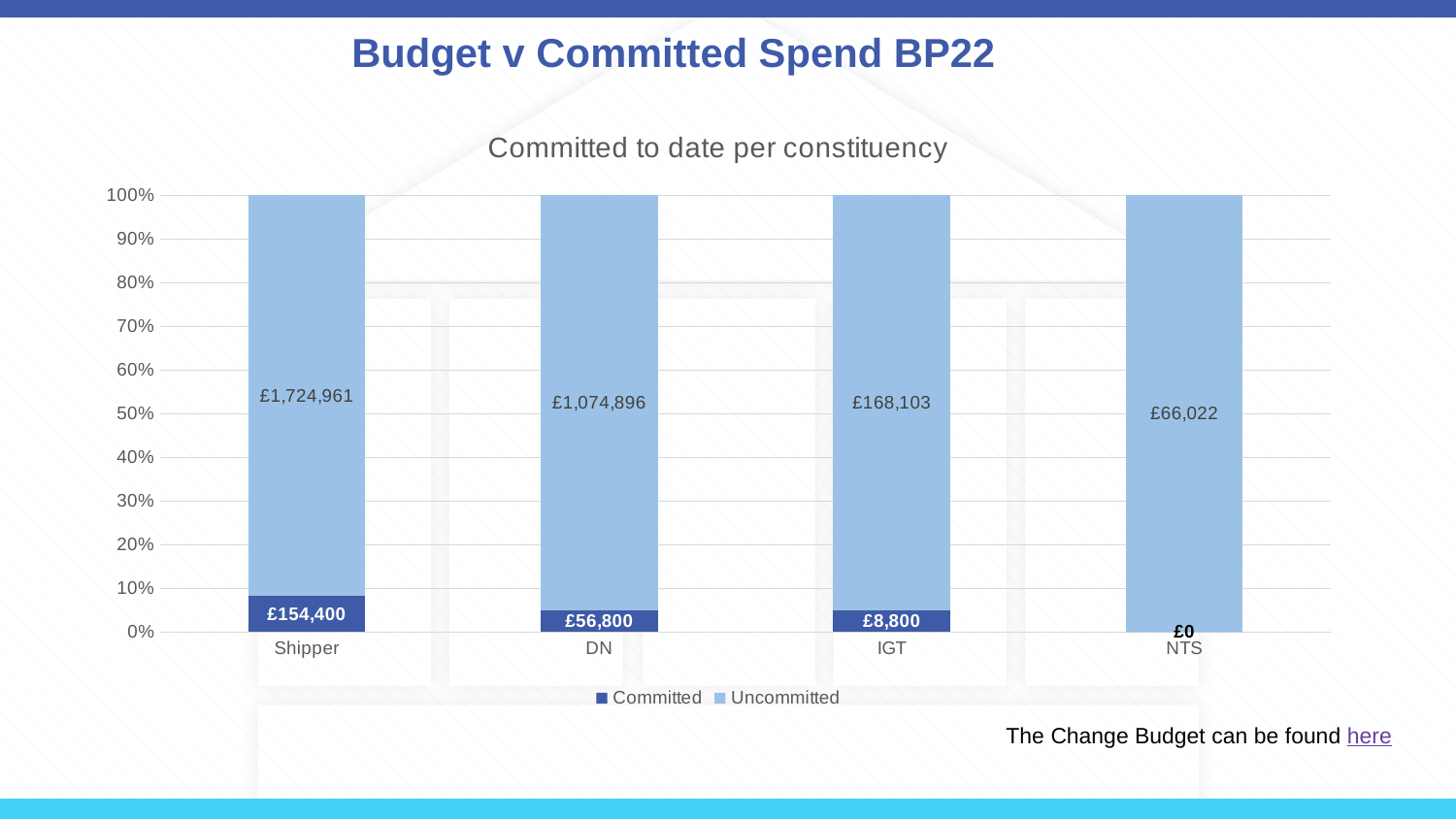
What is the Uncommitted value for DN? £1,074,896 Which constituency has the highest Committed value? Shipper Which is larger, the Uncommitted value for IGT or the Uncommitted value for NTS? IGT What is the difference between the Committed values for Shipper and DN? £97,600 How many series does the legend list? 2 What kind of chart is shown? Stacked bar chart What is the total of the Committed and Uncommitted values for IGT? £176,903 What is the Uncommitted value for IGT? £168,103 How many constituencies are shown on the x axis? 4 What is the Committed value for NTS? £0 What is the Committed value for Shipper? £154,400 Which constituency has the lowest Uncommitted value? NTS